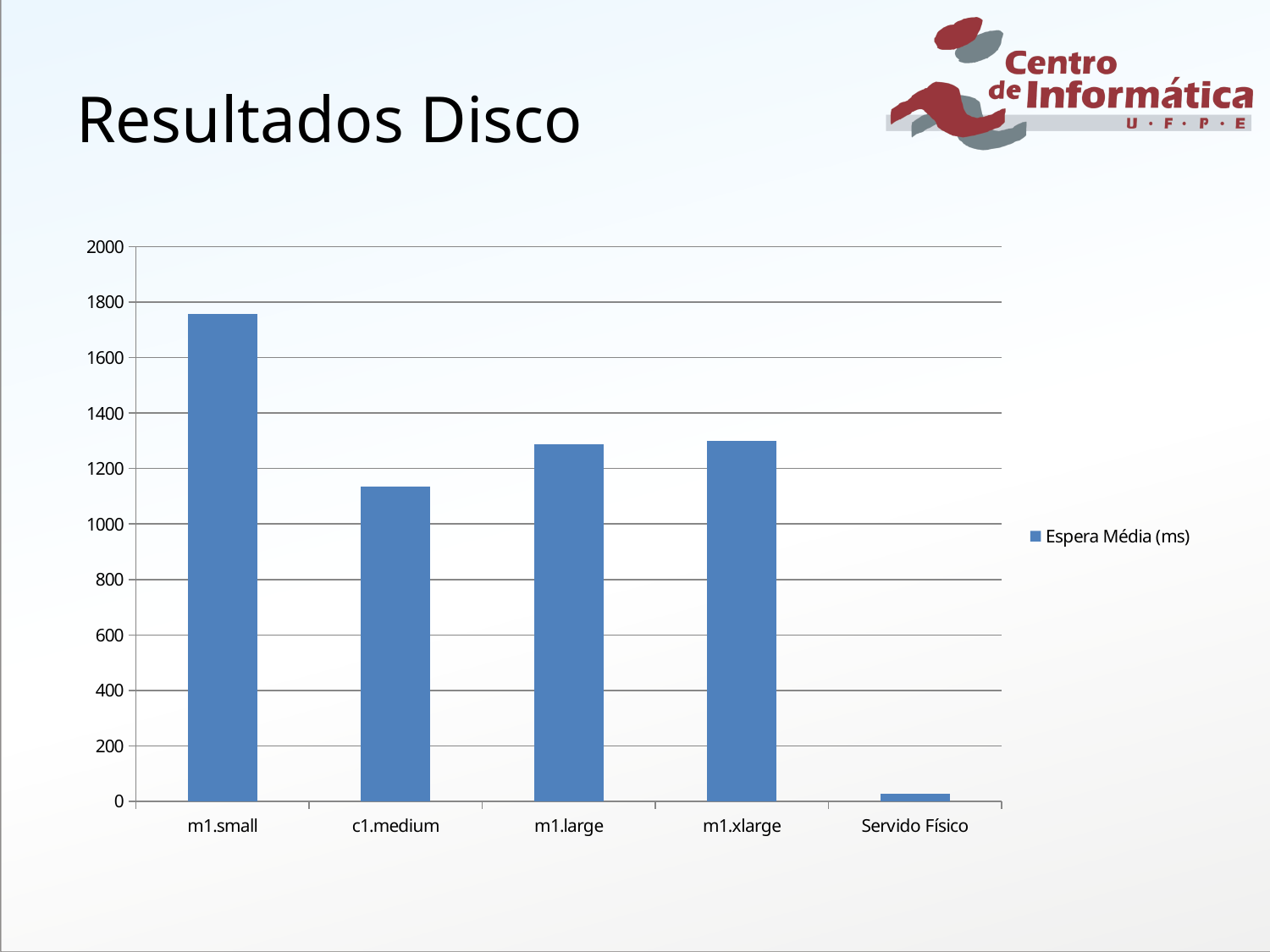
Which has a larger value, m1.small or c1.medium? m1.small Which category has the lowest value in the chart? Servido Físico Which has a larger value, c1.medium or m1.large? m1.large How many categories are shown on the x axis of the chart? 5 Is the value for Servido Físico greater or less than 200? less Which category has the highest value in the chart? m1.small Is the value for m1.small greater or less than 1600? greater Is the value for c1.medium greater or less than 1200? less What is the name of the series shown in the chart legend? Espera Média (ms) How many series does the chart legend list? 1 What kind of chart is shown on the slide? bar chart